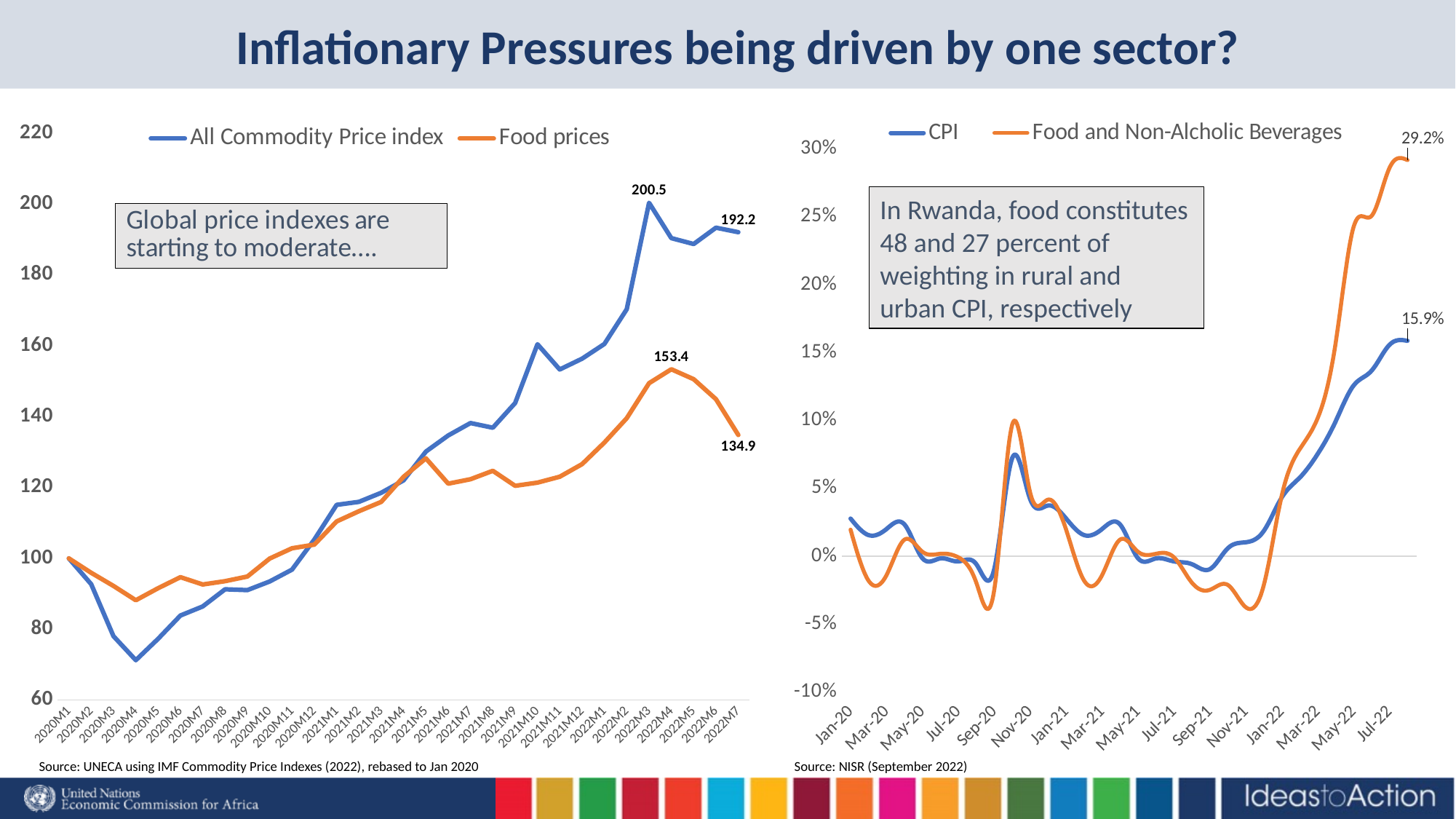
On the right chart, what is the difference between the latest labelled values for Food and Non-Alcholic Beverages (29.2%) and CPI (15.9%)? 13.3 percentage points On the left chart, how many monthly points are shown on the x axis? 31 On the left chart, what is the value of Food prices at 2022M7? 134.9 On the right chart, what is the latest labelled value for Food and Non-Alcholic Beverages? 29.2% On the right chart, is the CPI value at Sep-20 greater or less than 0%? less On the left chart, what is the peak value labelled for the All Commodity Price index? 200.5 On the left chart, how much higher is the All Commodity Price index (192.2) than Food prices (134.9) at 2022M7? 57.3 On the left chart, what is the difference between the All Commodity Price index peak of 200.5 and its 2022M7 value of 192.2? 8.3 On the left chart, how many series does the legend list? 2 What type of chart is shown on the left side of the slide? line chart On the left chart, do Food prices rise or fall between 2022M4 and 2022M7? fall On the left chart, is the All Commodity Price index at 2020M4 greater or less than 80? less